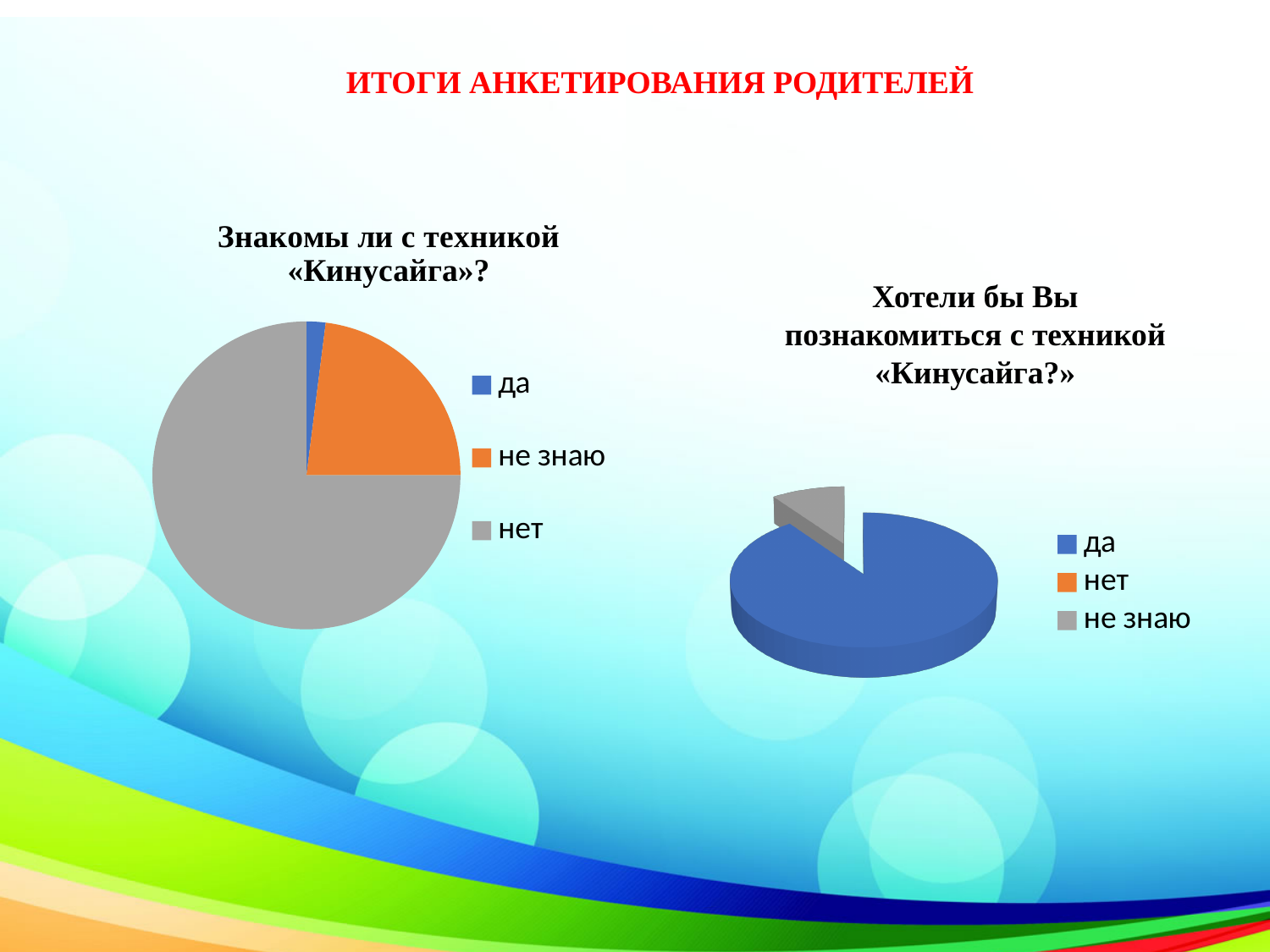
In the right chart «Хотели бы Вы познакомиться с техникой «Кинусайга?»», which category has the largest slice? да In the left chart «Знакомы ли с техникой «Кинусайга»?», which slice is larger: «не знаю» or «да»? не знаю How many categories does the legend of the right chart «Хотели бы Вы познакомиться с техникой «Кинусайга?»» list? 3 What kind of chart is the right chart titled «Хотели бы Вы познакомиться с техникой «Кинусайга?»»? pie chart In the right chart «Хотели бы Вы познакомиться с техникой «Кинусайга?»», which slice is larger: «да» or «не знаю»? да In the left chart «Знакомы ли с техникой «Кинусайга»?», which category has the smallest slice? да In the left chart «Знакомы ли с техникой «Кинусайга»?», which colour represents «не знаю»? orange In the left chart «Знакомы ли с техникой «Кинусайга»?», which category has the largest slice? нет What is the title of the slide containing the two pie charts? ИТОГИ АНКЕТИРОВАНИЯ РОДИТЕЛЕЙ How many categories does the legend of the left chart «Знакомы ли с техникой «Кинусайга»?» list? 3 What kind of chart is the left chart titled «Знакомы ли с техникой «Кинусайга»?»? pie chart